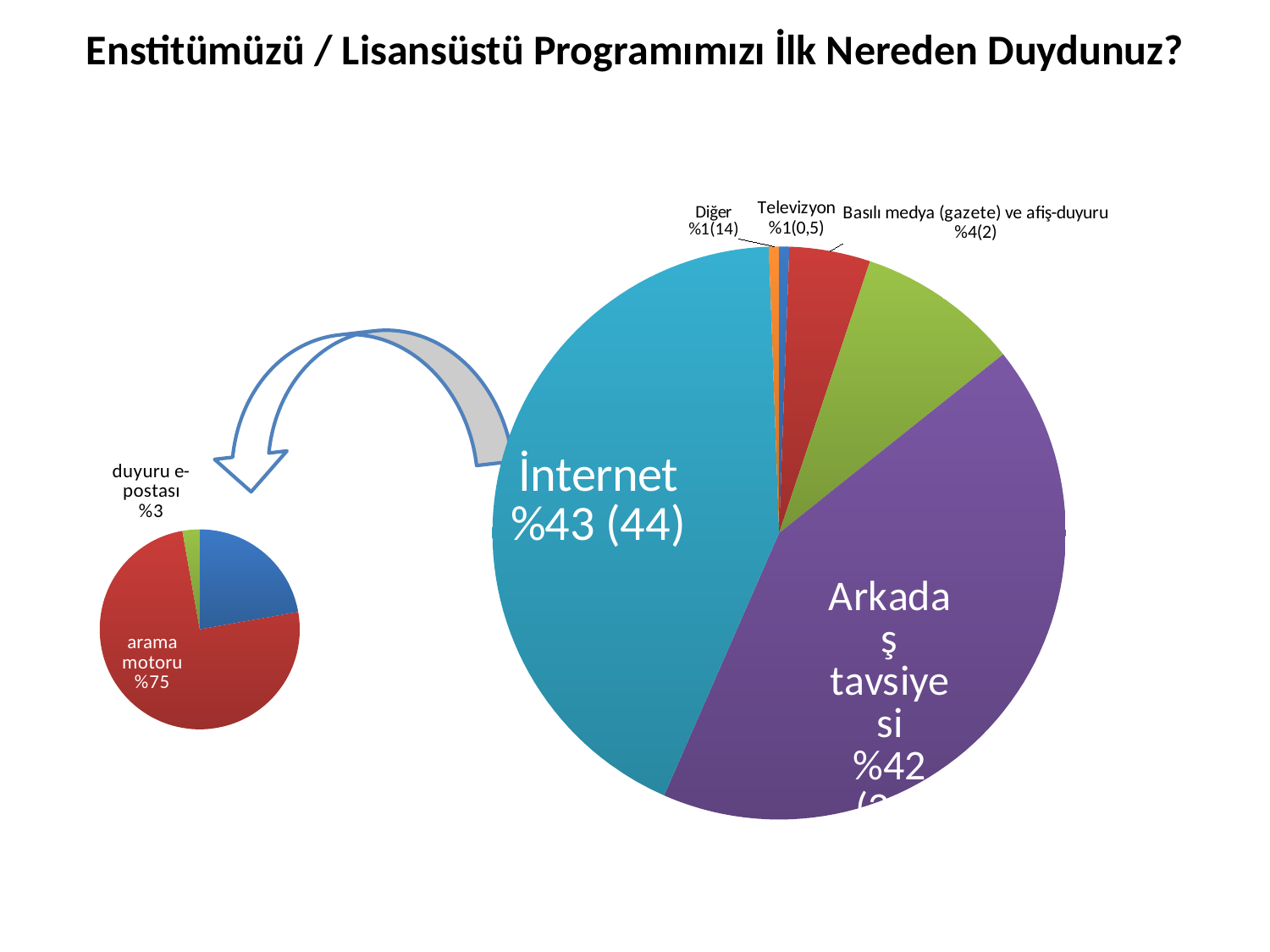
In the large pie chart, what is the difference in percentage points between İnternet and Arkadaş tavsiyesi? 1 In the small pie chart on the left, what percentage is shown for arama motoru? %75 In the large pie chart, which of İnternet or Arkadaş tavsiyesi has the larger printed percentage? İnternet In the large pie chart, what percentage is shown for İnternet? %43 What is the title of the slide? Enstitümüzü / Lisansüstü Programımızı İlk Nereden Duydunuz? In the small pie chart on the left, which labelled slice is the largest? arama motoru In the large pie chart, what percentage is shown for Basılı medya (gazete) ve afiş-duyuru? %4 How many slices does the small pie chart on the left have? 3 In the large pie chart, what percentage is shown for Televizyon? %1 In the large pie chart, what percentage is shown for Arkadaş tavsiyesi? %42 What kind of chart is the large chart on the right of the slide? pie chart In the small pie chart on the left, what percentage is shown for duyuru e-postası? %3